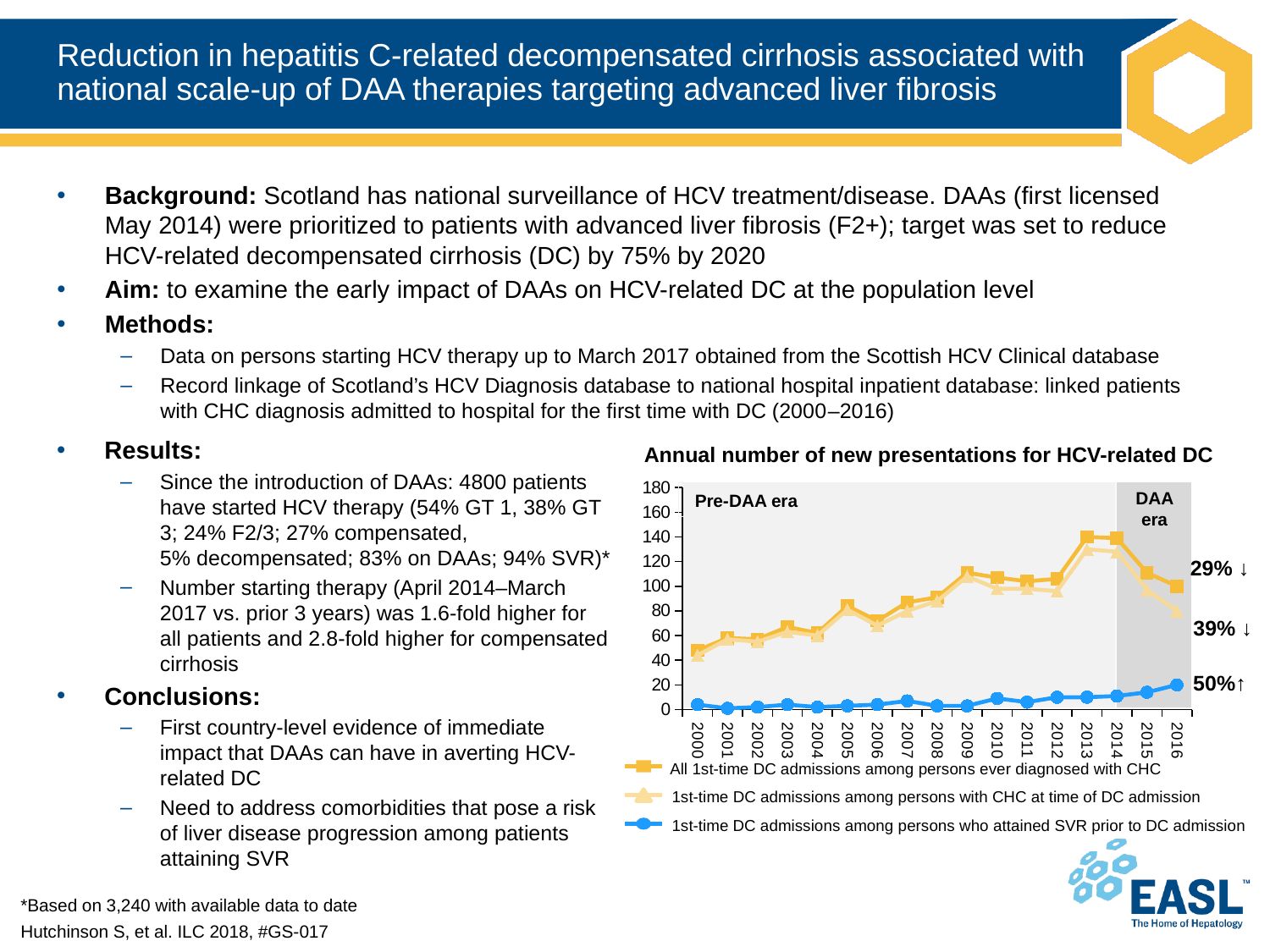
Is the 2000 value for 'All 1st-time DC admissions among persons ever diagnosed with CHC' greater or less than 60? less How many series does the chart legend list? 3 Is the 2013 value for 'All 1st-time DC admissions among persons ever diagnosed with CHC' greater or less than 120? greater What is the title of the chart? Annual number of new presentations for HCV-related DC How many years are plotted along the x axis of the chart? 17 Is the 2016 value for '1st-time DC admissions among persons who attained SVR prior to DC admission' greater or less than 40? less What label is shown on the shaded region at the right of the chart? DAA era Which year has the lowest value for 'All 1st-time DC admissions among persons ever diagnosed with CHC'? 2000 Does the series '1st-time DC admissions among persons who attained SVR prior to DC admission' rise or fall from 2000 to 2016? rise In 2016, which series has the higher value: 'All 1st-time DC admissions among persons ever diagnosed with CHC' or '1st-time DC admissions among persons who attained SVR prior to DC admission'? All 1st-time DC admissions among persons ever diagnosed with CHC What kind of chart is shown on the slide? line chart